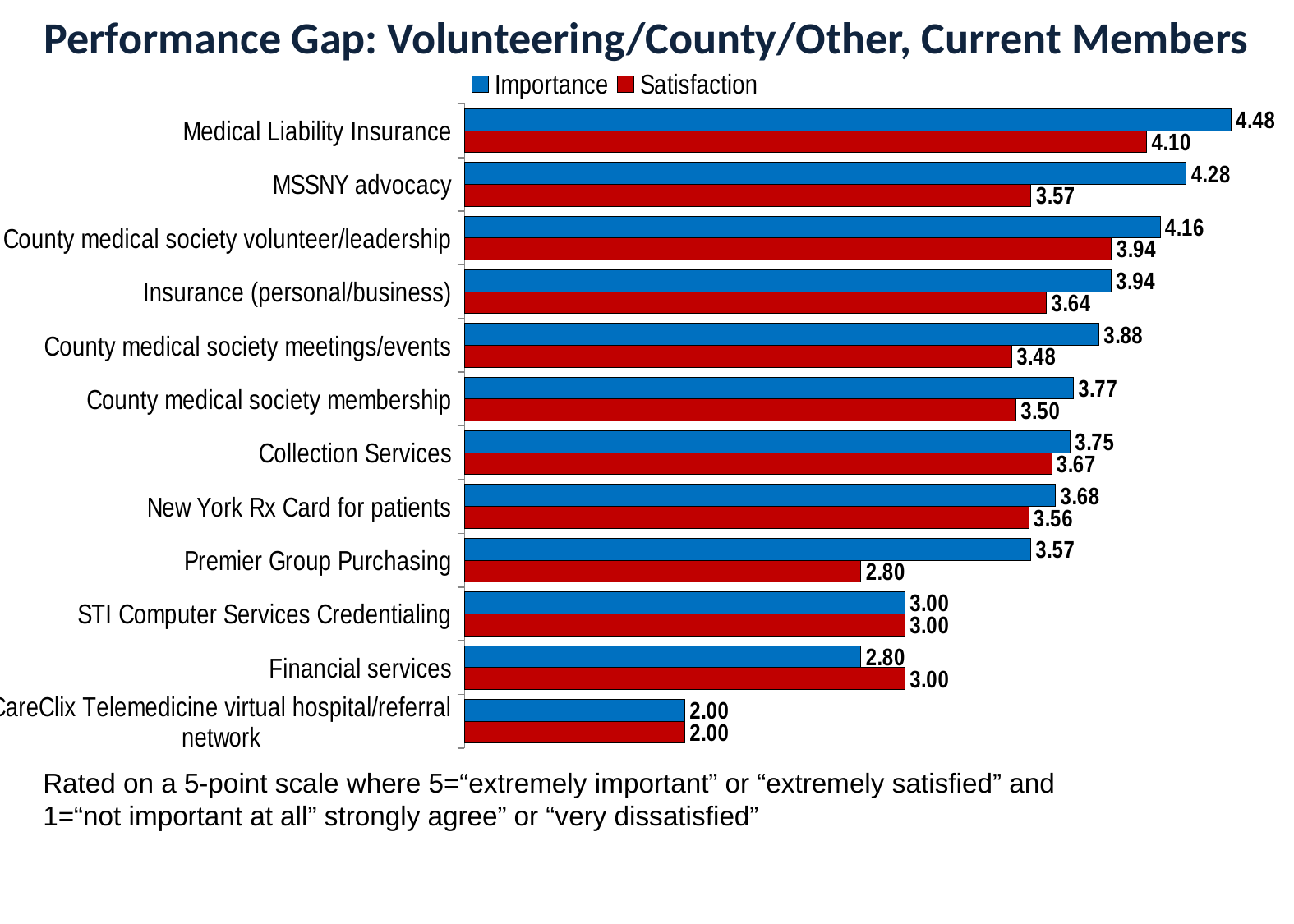
What is the difference between Importance and Satisfaction for Premier Group Purchasing? 0.77 What is the Satisfaction value for Premier Group Purchasing? 2.80 Which colour represents the Satisfaction series? Red What kind of chart is shown on the slide? Bar chart How many series does the legend list? 2 Which category has the highest Importance value? Medical Liability Insurance How many categories are shown in the chart? 12 What is the difference between Importance and Satisfaction for MSSNY advocacy? 0.71 Which is larger for Financial services, Importance or Satisfaction? Satisfaction What is the Importance value for Medical Liability Insurance? 4.48 Which category has the lowest Satisfaction value? CareClix Telemedicine virtual hospital/referral network What is the Satisfaction value for MSSNY advocacy? 3.57